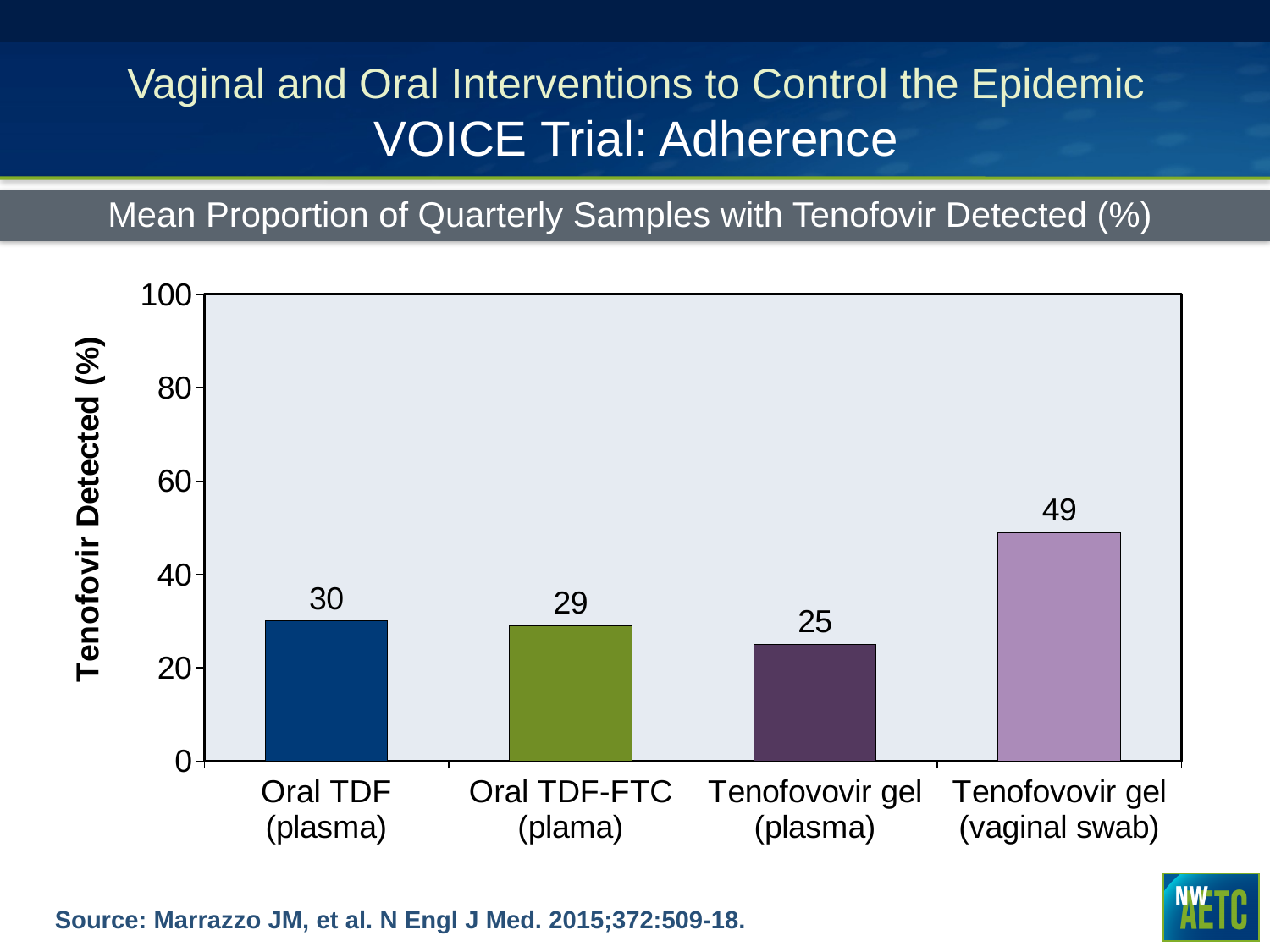
What is the value for Oral TDF (plasma)? 30 What is the difference between the values for Tenofovovir gel (vaginal swab) and Oral TDF (plasma)? 19 What kind of chart is shown on the slide? bar chart What is the difference between the values for Oral TDF-FTC (plama) and Tenofovovir gel (plasma)? 4 Which category has the lowest value? Tenofovovir gel (plasma) What is the label of the y axis? Tenofovir Detected (%) Which is larger, the value for Oral TDF (plasma) or the value for Tenofovovir gel (plasma)? Oral TDF (plasma) Which category has the highest value? Tenofovovir gel (vaginal swab) How many categories are shown on the x axis? 4 What is the value for Tenofovovir gel (vaginal swab)? 49 What is the value for Tenofovovir gel (plasma)? 25 Is the value for Tenofovovir gel (vaginal swab) greater or less than 40? greater